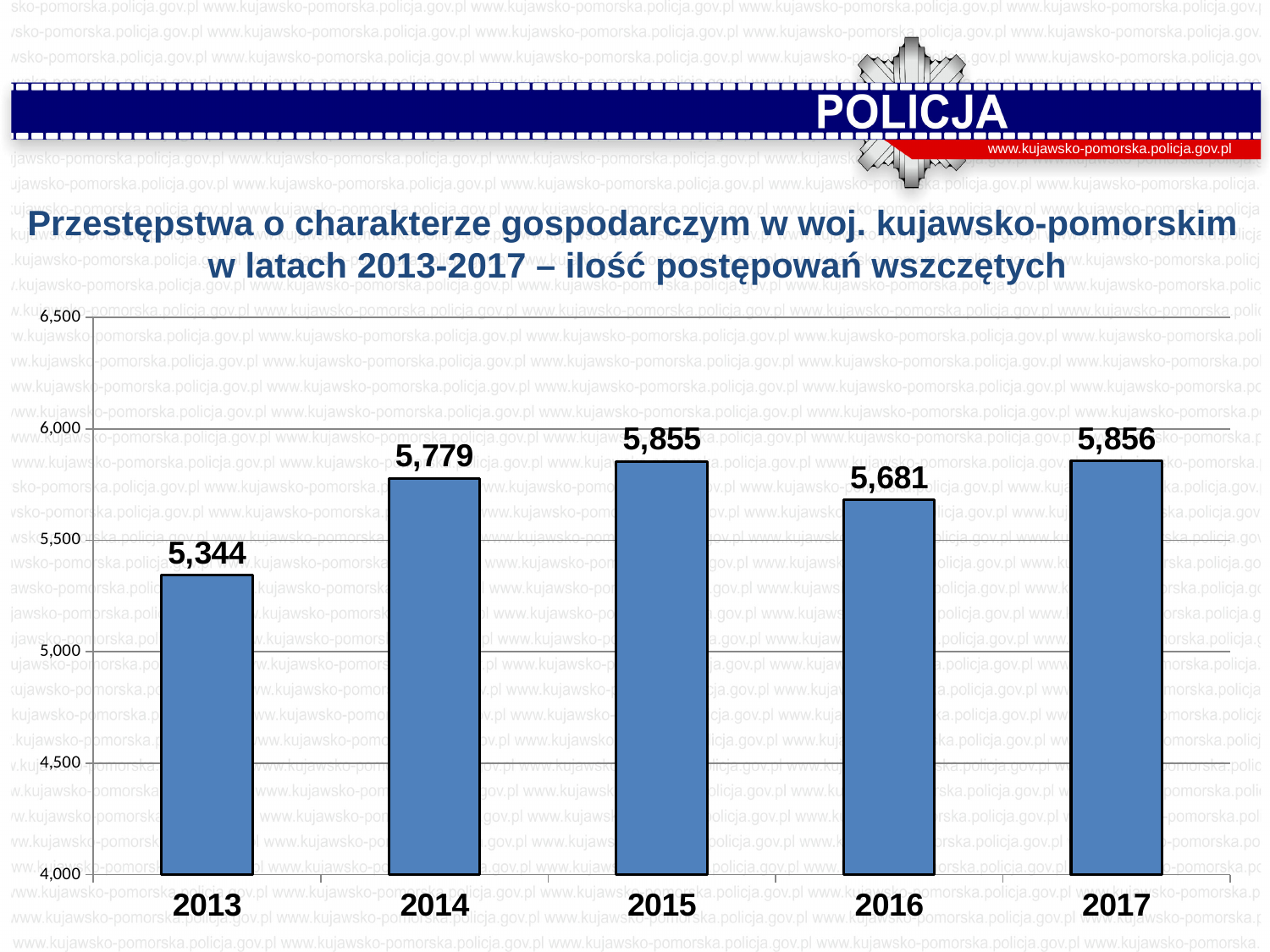
What is the difference between the values for 2014 and 2013? 435 How many years are shown on the x axis? 5 What is the value for 2014? 5,779 Which year has the lowest value? 2013 Does the value rise or fall from 2015 to 2016? fall Which is larger, the value for 2014 or the value for 2016? 2014 What is the value for 2016? 5,681 What is the difference between the values for 2015 and 2016? 174 What is the value for 2013? 5,344 Is the value for 2017 greater or less than 5,500? greater What kind of chart is shown on the slide? bar chart Is the value for 2013 greater or less than 5,500? less